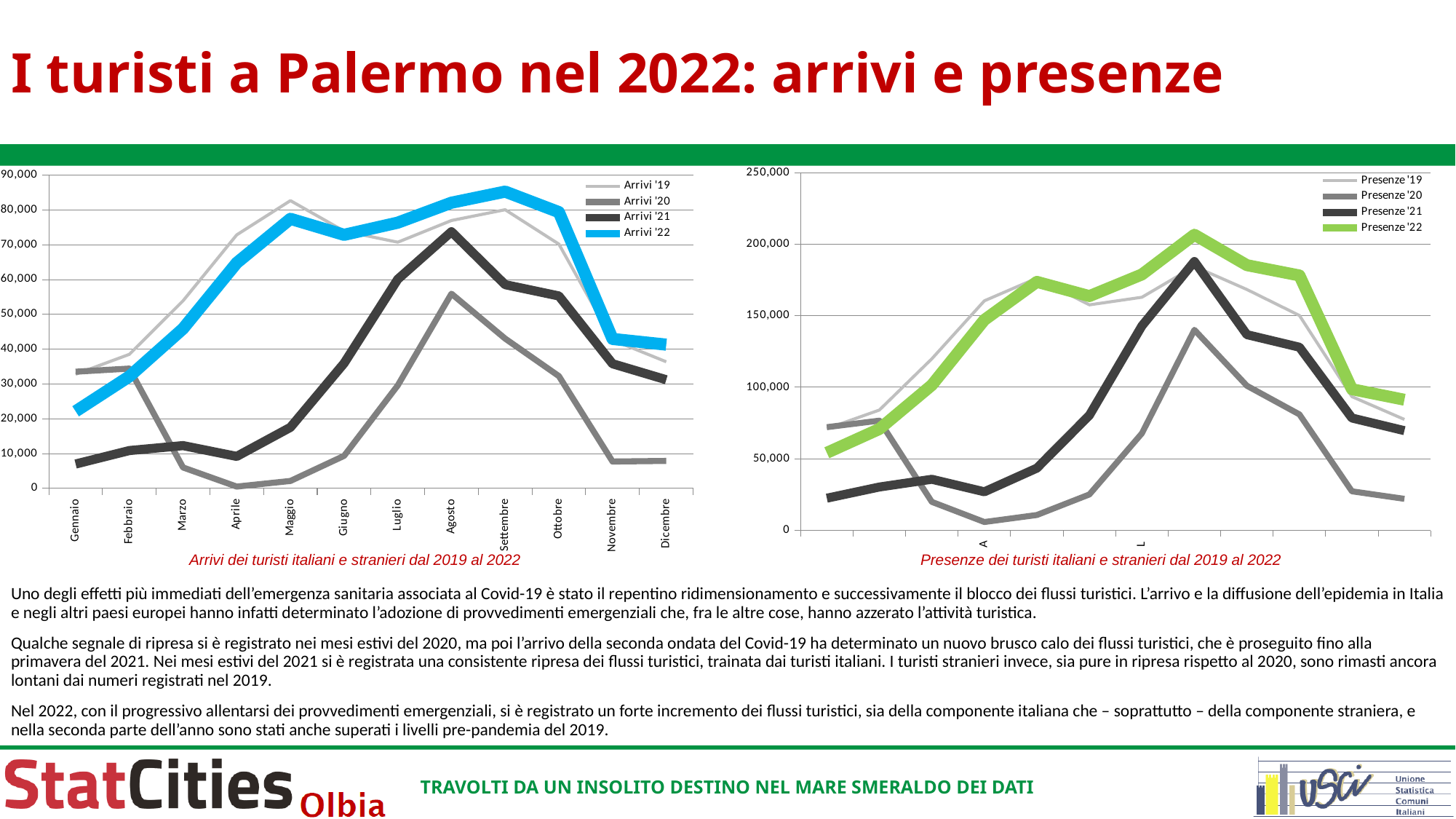
In the left chart (Arrivi), is the Arrivi '21 value for Gennaio greater or less than 10,000? less What kind of chart is the left chart, 'Arrivi dei turisti italiani e stranieri dal 2019 al 2022'? Line chart In the left chart (Arrivi), which is larger in Gennaio: Arrivi '20 or Arrivi '21? Arrivi '20 In the right chart (Presenze), which series is drawn in green? Presenze '22 In the right chart (Presenze), is the peak value of the Presenze '20 series greater or less than 150,000? less In the left chart (Arrivi), is the Arrivi '22 value for Settembre greater or less than 80,000? greater In the left chart (Arrivi), in which month does the Arrivi '22 series reach its highest value? Settembre How many months are shown on the x axis of the left chart (Arrivi)? 12 In the left chart (Arrivi), does the Arrivi '22 series rise or fall from Settembre to Dicembre? Fall How many series does the legend of the left chart (Arrivi) list? 4 In the left chart (Arrivi), in which month does the Arrivi '20 series reach its lowest value? Aprile